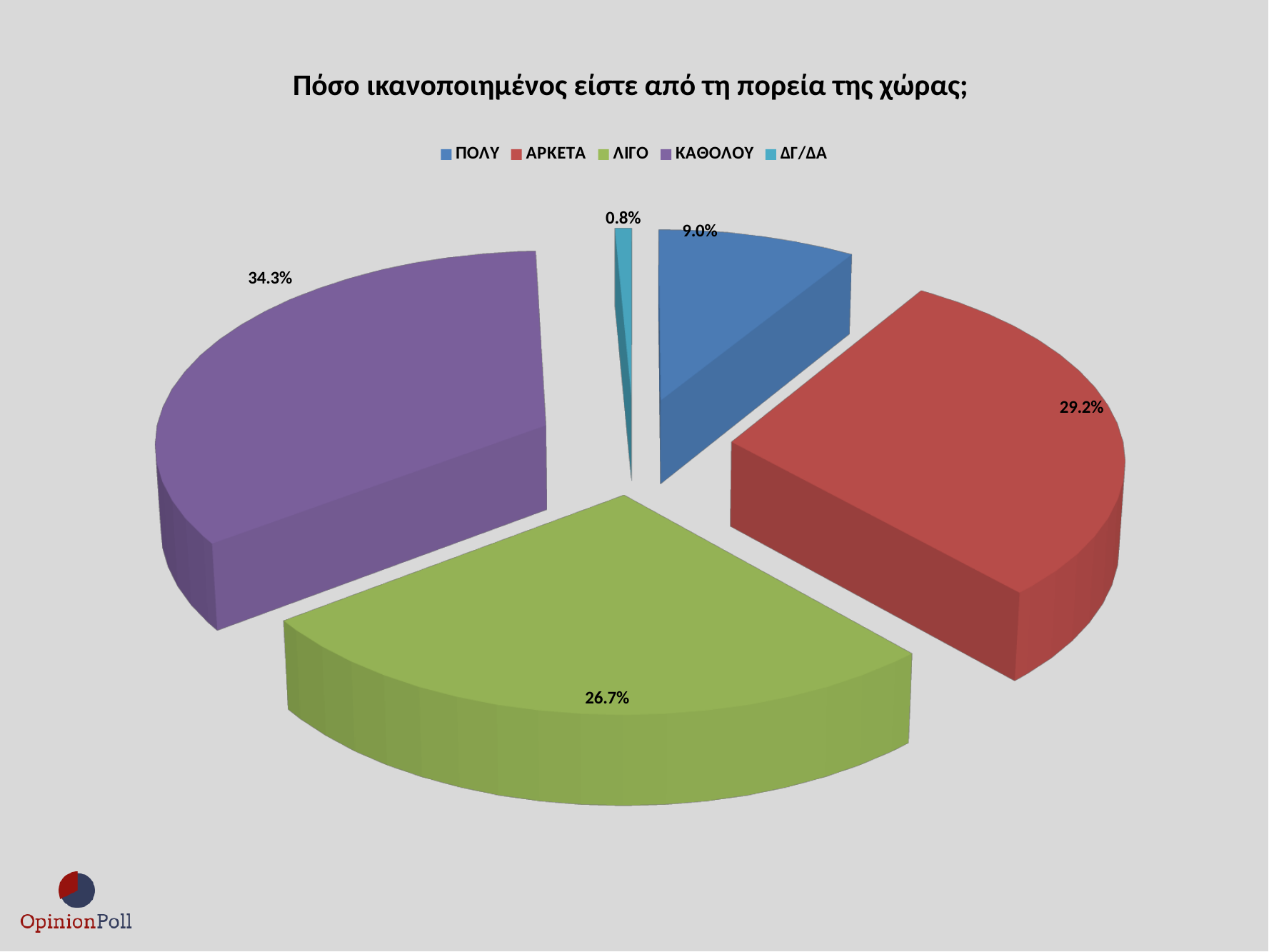
Which is larger, the value for ΑΡΚΕΤΑ or the value for ΛΙΓΟ? ΑΡΚΕΤΑ What is the value for ΚΑΘΟΛΟΥ? 34.3% What colour is the slice for ΛΙΓΟ? Green What is the value for ΑΡΚΕΤΑ? 29.2% What kind of chart is shown on the slide? Pie chart What is the value for ΠΟΛΥ? 9.0% What is the value for ΔΓ/ΔΑ? 0.8% Which category has the largest share of the pie? ΚΑΘΟΛΟΥ What is the value for ΛΙΓΟ? 26.7% What is the difference between the values for ΚΑΘΟΛΟΥ and ΠΟΛΥ? 25.3% Which category has the smallest share of the pie? ΔΓ/ΔΑ How many categories does the legend list? 5